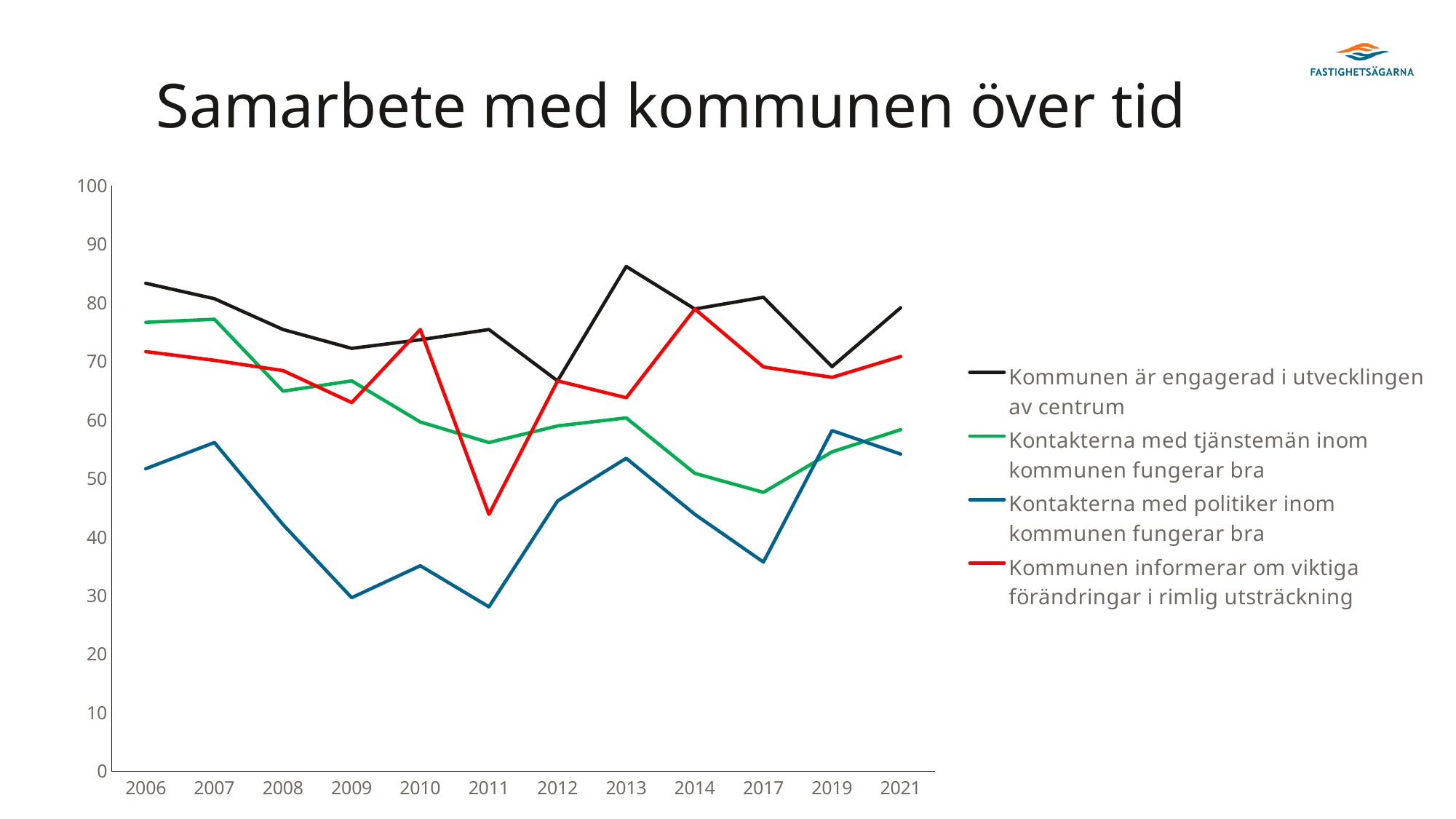
How many series does the legend list? 4 How many years are shown on the x axis? 12 Is the value for 'Kontakterna med politiker inom kommunen fungerar bra' in 2011 greater or less than 30? less In 2021, which series has the larger value: 'Kontakterna med tjänstemän inom kommunen fungerar bra' or 'Kontakterna med politiker inom kommunen fungerar bra'? Kontakterna med tjänstemän inom kommunen fungerar bra What is the title of the chart? Samarbete med kommunen över tid In which year does the series 'Kommunen är engagerad i utvecklingen av centrum' reach its highest value? 2013 In which year does the series 'Kommunen informerar om viktiga förändringar i rimlig utsträckning' reach its lowest value? 2011 Is the value for 'Kommunen är engagerad i utvecklingen av centrum' in 2013 greater or less than 80? greater What kind of chart is shown on the slide? Line chart Is the value for 'Kommunen informerar om viktiga förändringar i rimlig utsträckning' in 2011 greater or less than 50? less In which year does the series 'Kontakterna med politiker inom kommunen fungerar bra' reach its lowest value? 2011 Does the series 'Kommunen är engagerad i utvecklingen av centrum' rise or fall from 2006 to 2009? Fall